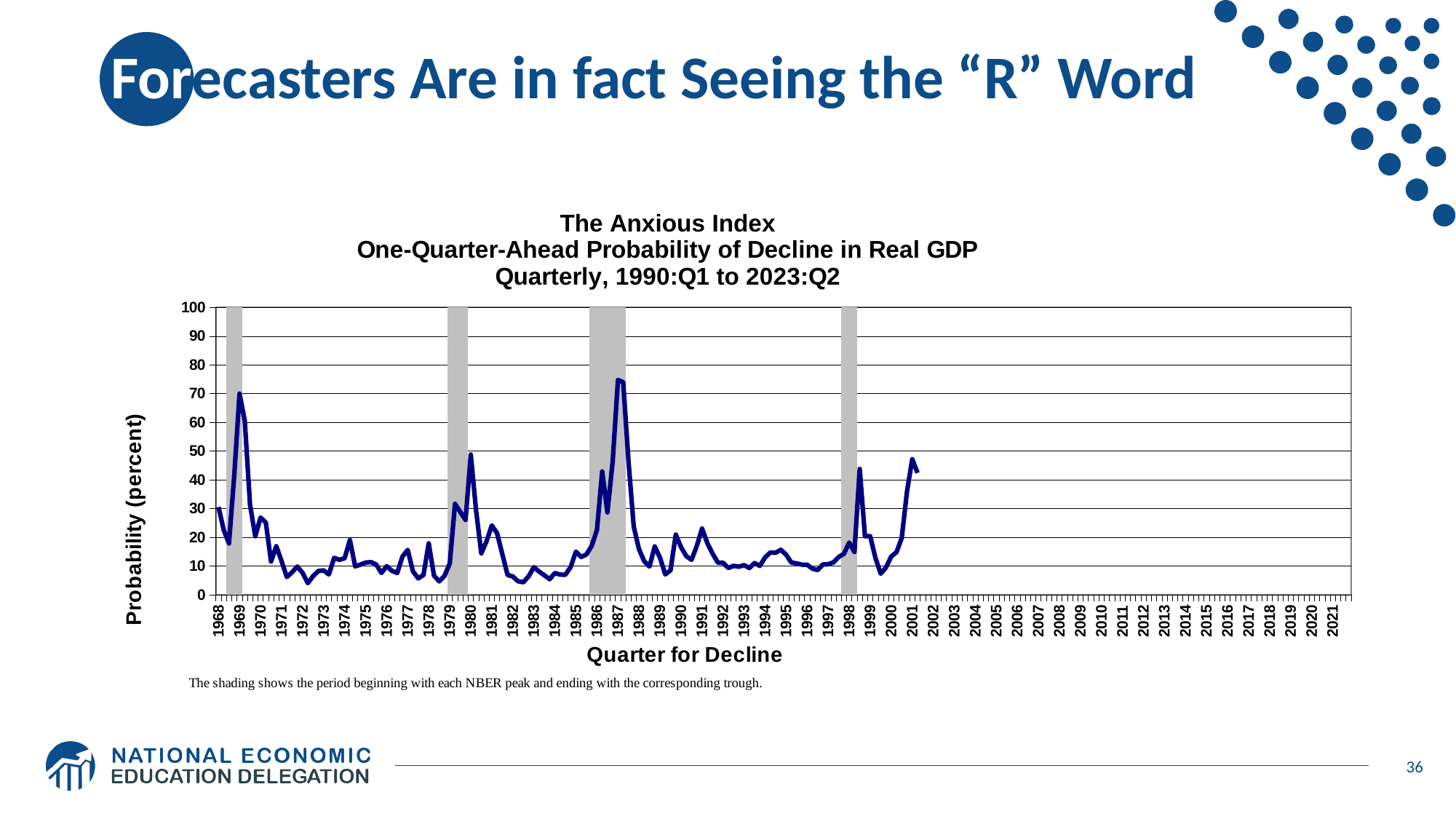
Around which year on the x axis does the line reach its highest peak? 1987 What is the label on the vertical axis of the chart? Probability (percent) How many shaded recession periods are shown on the chart? 4 What is the title of the chart? The Anxious Index One-Quarter-Ahead Probability of Decline in Real GDP Quarterly, 1990:Q1 to 2023:Q2 Is the peak value of the line around 1987 greater or less than 70? greater Is the value of the line around 1972 greater or less than 10? less Is the peak value of the line around 1998 greater or less than 50? less What kind of chart is shown on the slide? line chart What is the highest value shown on the vertical axis? 100 Which peak is higher: the one around 1969 or the one around 1987? 1987